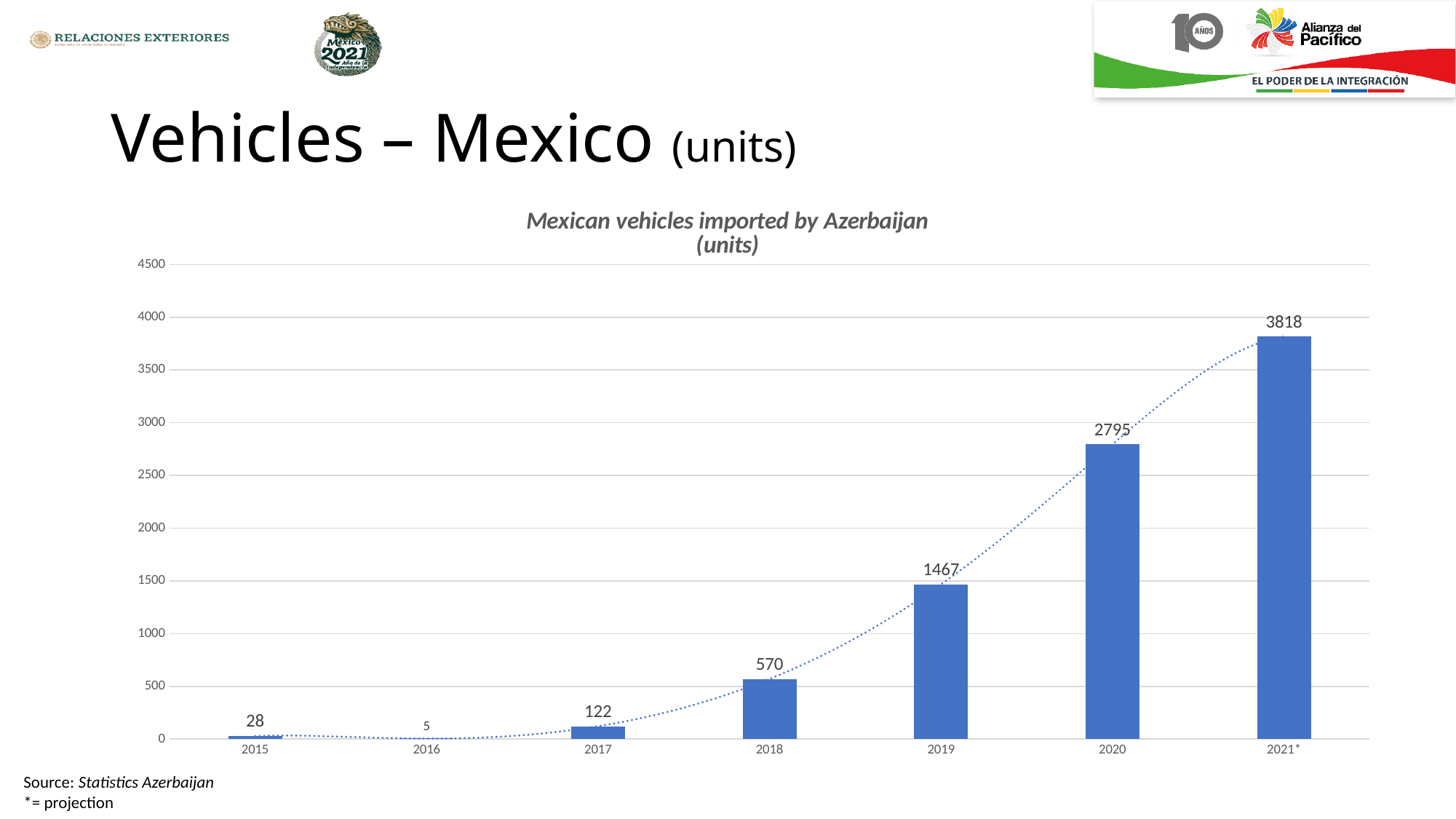
Which is larger, the value for 2018 or the value for 2019? 2019 Do the values rise or fall from 2016 to 2021*? rise How many years are shown on the x axis? 7 Is the value for 2020 greater or less than 2500? greater What is the difference between the values for 2018 and 2017? 448 Which year has the lowest value? 2016 What is the value for 2016? 5 Which year has the highest value? 2021* What is the value for 2019? 1467 What is the difference between the values for 2021* and 2020? 1023 What is the value for 2021*? 3818 What kind of chart is this? bar chart